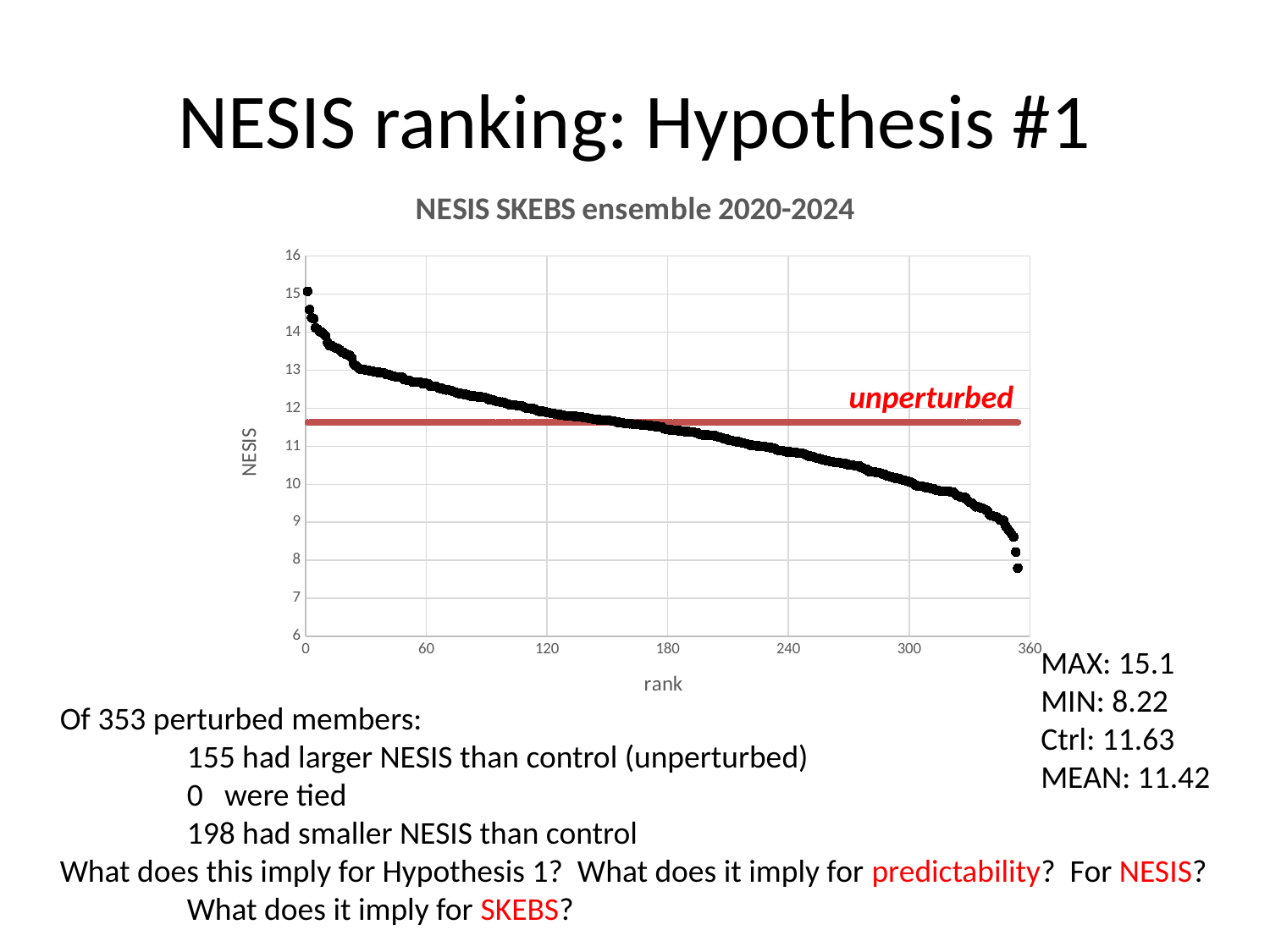
Is the NESIS value at rank 60 greater or less than 12? greater Is the NESIS value at rank 300 greater or less than 11? less What is the maximum NESIS value among the perturbed members? 15.1 How many perturbed members are plotted on the chart? 353 What is the title of the chart? NESIS SKEBS ensemble 2020-2024 What is the minimum NESIS value among the perturbed members? 8.22 What is the difference between the maximum and minimum NESIS values? 6.88 What label is given to the red horizontal line on the chart? unperturbed What is the mean NESIS value of the ensemble? 11.42 What kind of chart is shown on the slide? scatter chart What is the NESIS value of the control (unperturbed) run shown by the red line? 11.63 Do the plotted NESIS values rise or fall as rank increases along the x axis? fall